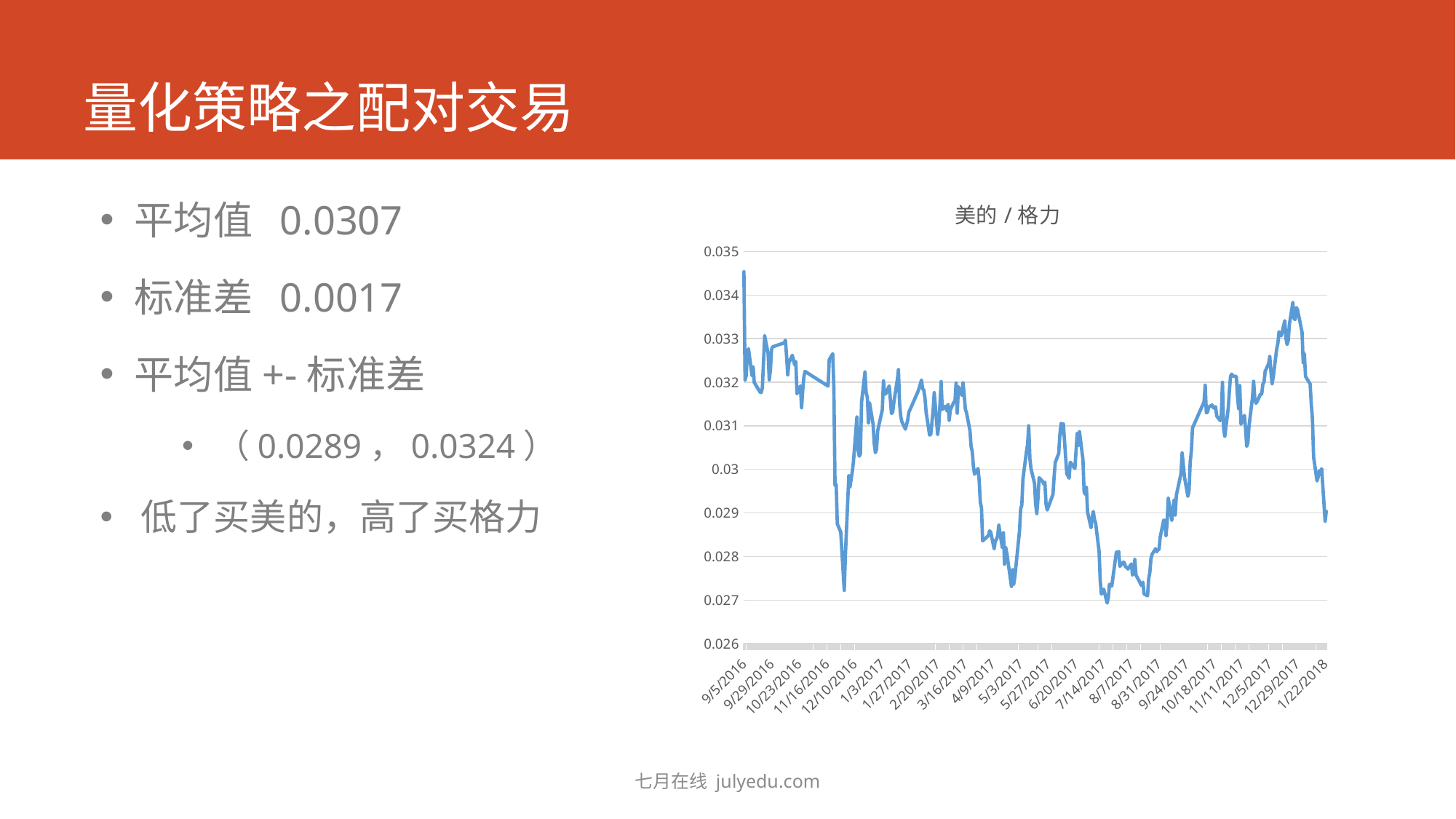
Is the value at 9/5/2016 greater or less than 0.034? greater How many date labels are shown on the horizontal axis? 22 Is the value around 7/14/2017 greater or less than 0.028? less How many data series are plotted in the chart? 1 What is the title of the chart? 美的 / 格力 Does the line rise or fall between 12/29/2017 and 1/22/2018? fall Is the value around 12/29/2017 greater or less than 0.033? greater What kind of chart is shown on the slide? line chart Does the line rise or fall between 7/14/2017 and 12/29/2017? rise What is the highest value shown on the vertical axis? 0.035